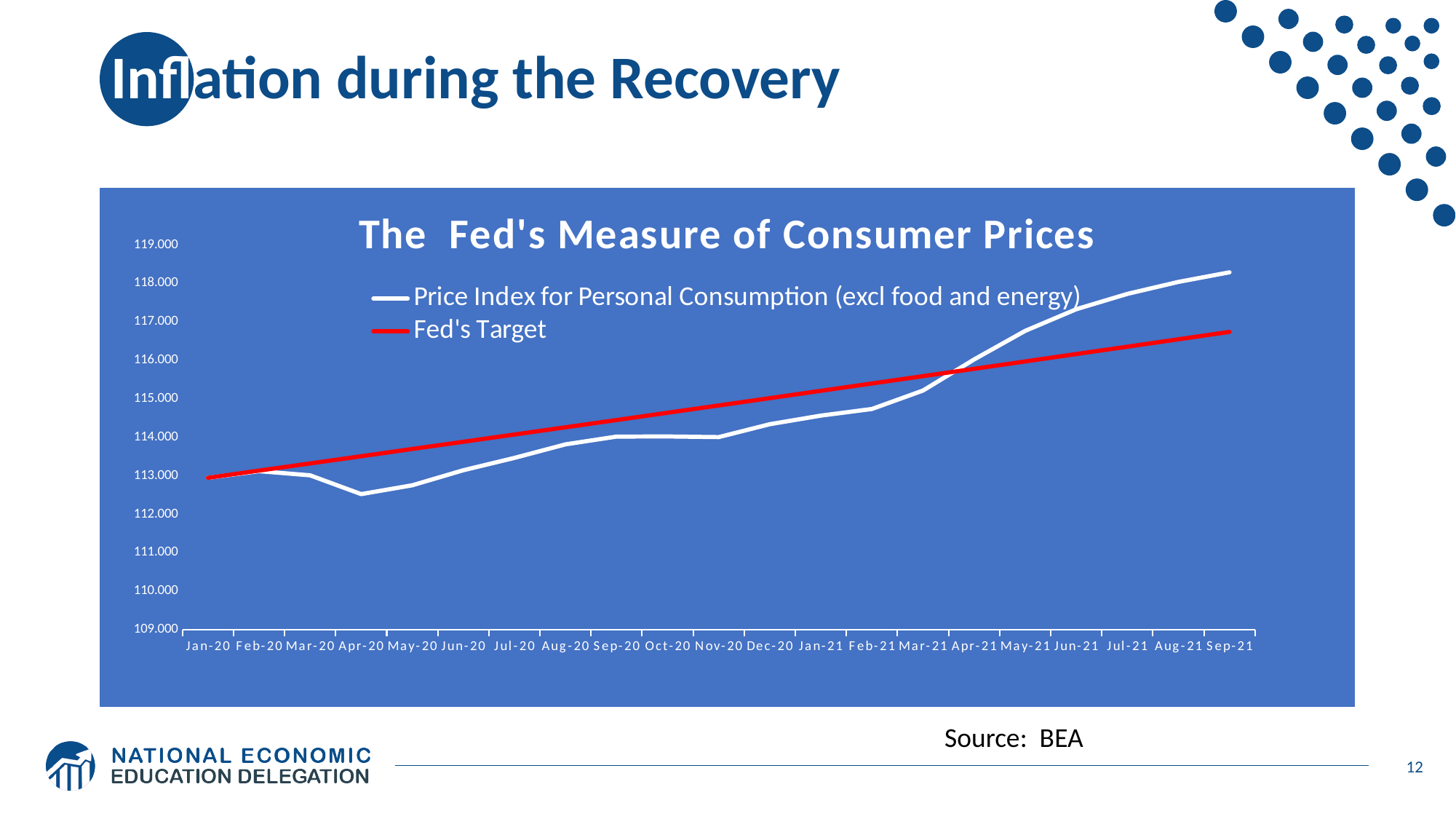
Is the Fed's Target value in Sep-21 greater or less than 117.000? less How many series does the legend list? 2 Does the Fed's Target line rise or fall from Jan-20 to Sep-21? rise What kind of chart is shown on the slide? line chart Is the Price Index for Personal Consumption (excl food and energy) in Apr-20 greater or less than 113.000? less In which month is the Price Index for Personal Consumption (excl food and energy) at its highest? Sep-21 How many months are shown on the x axis? 21 In Apr-20, which is higher: the Price Index for Personal Consumption (excl food and energy) or the Fed's Target? Fed's Target What is the title of the chart? The Fed's Measure of Consumer Prices In which month is the Price Index for Personal Consumption (excl food and energy) at its lowest? Apr-20 Is the Price Index for Personal Consumption (excl food and energy) in Sep-21 greater or less than 118.000? greater Which series is drawn in red? Fed's Target